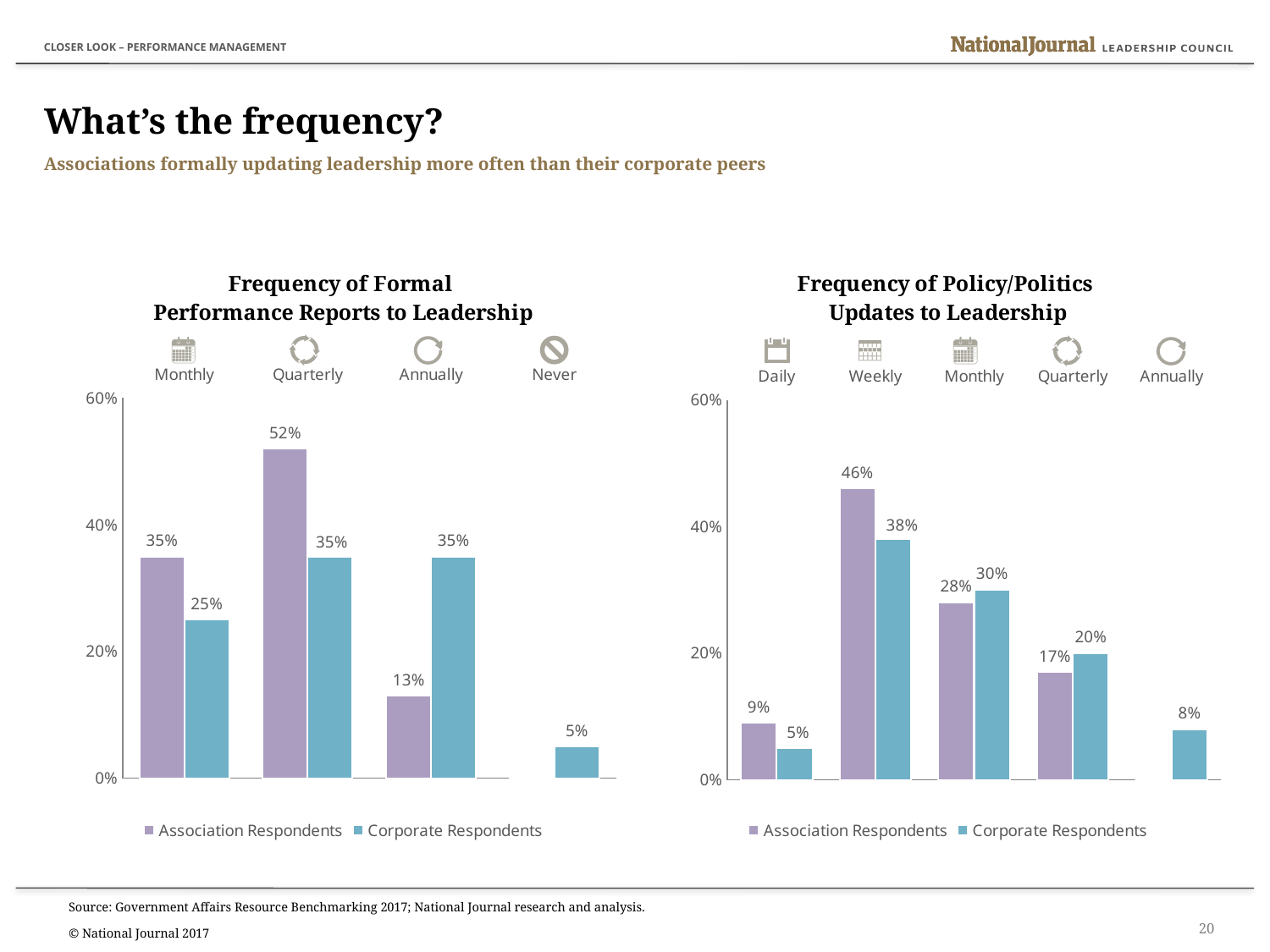
In the 'Frequency of Policy/Politics Updates to Leadership' chart, what percentage of Corporate Respondents report Weekly? 38% In the 'Frequency of Policy/Politics Updates to Leadership' chart, what percentage of Association Respondents report Daily? 9% In the 'Frequency of Formal Performance Reports to Leadership' chart, what percentage of Corporate Respondents report Never? 5% What type of chart is the 'Frequency of Policy/Politics Updates to Leadership' chart? Bar chart In the 'Frequency of Formal Performance Reports to Leadership' chart, what percentage of Association Respondents report Quarterly? 52% In the 'Frequency of Policy/Politics Updates to Leadership' chart, which category has the lowest value for Corporate Respondents? Daily In the 'Frequency of Formal Performance Reports to Leadership' chart, what is the difference between Association Respondents and Corporate Respondents for Annually? 22% How many series does the legend of the 'Frequency of Formal Performance Reports to Leadership' chart list? 2 In the 'Frequency of Formal Performance Reports to Leadership' chart, which is larger for Monthly: Association Respondents or Corporate Respondents? Association Respondents How many categories are shown on the x axis of the 'Frequency of Policy/Politics Updates to Leadership' chart? 5 In the 'Frequency of Formal Performance Reports to Leadership' chart, which category has the highest value for Association Respondents? Quarterly In the 'Frequency of Policy/Politics Updates to Leadership' chart, what is the difference between Association Respondents and Corporate Respondents for Weekly? 8%